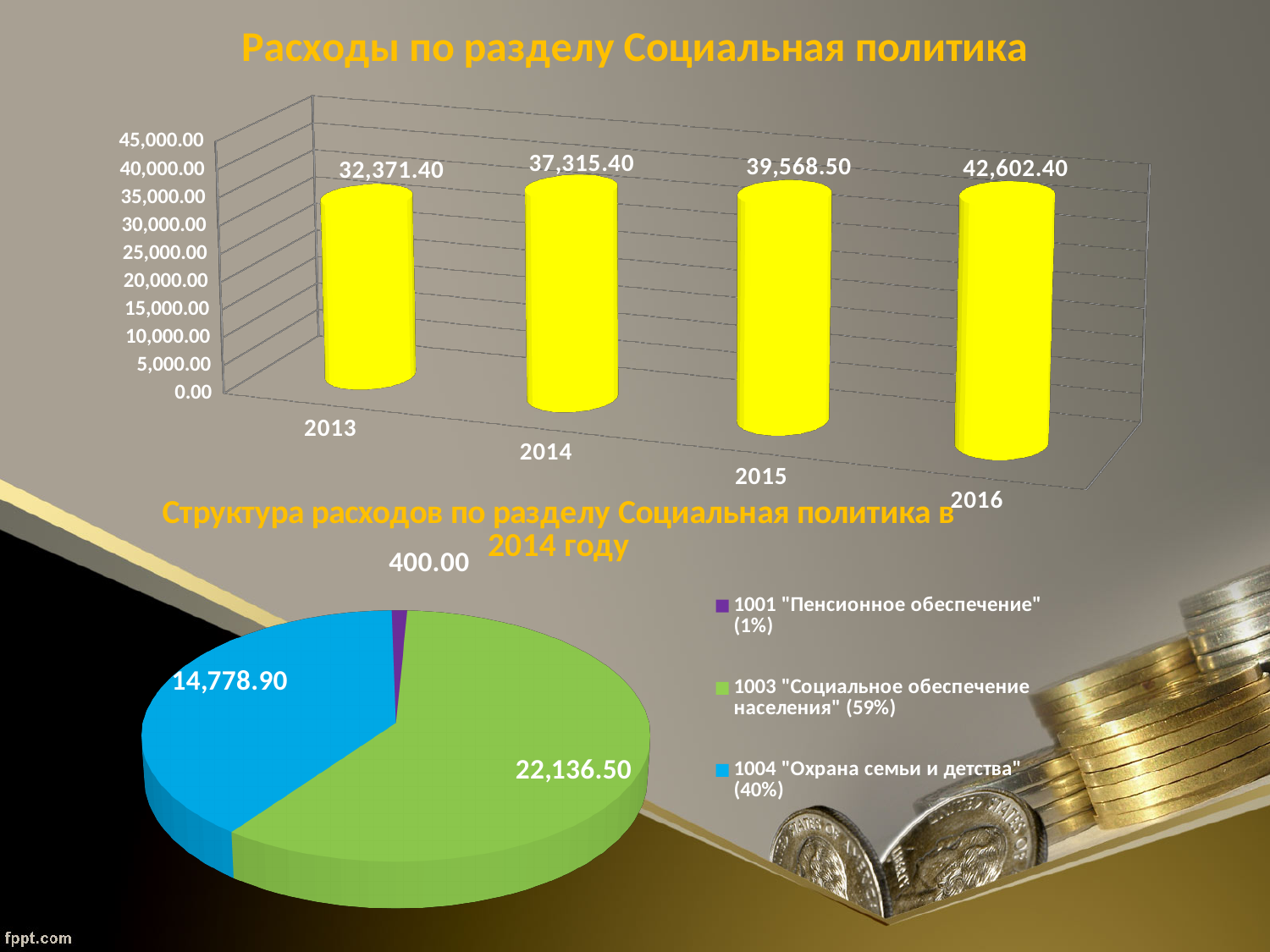
In the bar chart 'Расходы по разделу Социальная политика', which year has the lowest value? 2013 In the bar chart 'Расходы по разделу Социальная политика', what is the value for 2013? 32,371.40 In the bar chart 'Расходы по разделу Социальная политика', do the values rise or fall from 2013 to 2016? rise In the bar chart 'Расходы по разделу Социальная политика', how many years are shown? 4 In the pie chart 'Структура расходов по разделу Социальная политика в 2014 году', which category has the smallest slice? 1001 "Пенсионное обеспечение" In the bar chart 'Расходы по разделу Социальная политика', what is the value for 2016? 42,602.40 In the pie chart 'Структура расходов по разделу Социальная политика в 2014 году', what is the value for 1004 "Охрана семьи и детства"? 14,778.90 In the bar chart 'Расходы по разделу Социальная политика', what is the difference between the 2016 and 2013 values? 10,231.00 In the bar chart 'Расходы по разделу Социальная политика', which year has the highest value? 2016 What kind of chart is the top chart 'Расходы по разделу Социальная политика'? bar chart In the pie chart 'Структура расходов по разделу Социальная политика в 2014 году', what share does 1003 "Социальное обеспечение населения" have? 59% In the pie chart 'Структура расходов по разделу Социальная политика в 2014 году', how many categories does the legend list? 3